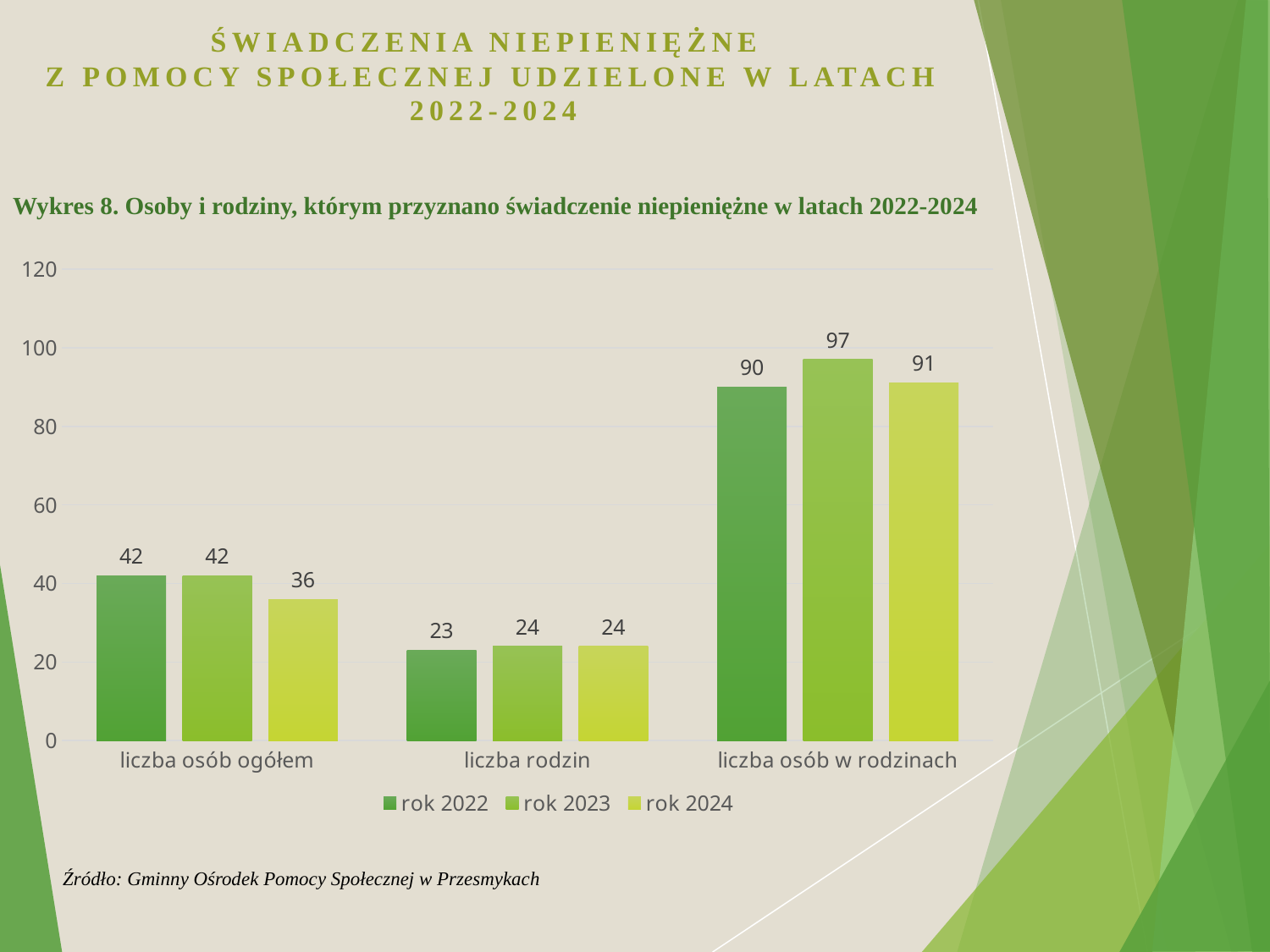
How many categories are shown on the x axis? 3 Which category has the lowest value in the 'rok 2024' series? liczba rodzin What is the value for 'liczba rodzin' in the 'rok 2022' series? 23 What is the difference between the 'rok 2022' and 'rok 2024' values for 'liczba osób ogółem'? 6 What is the difference between the 'rok 2023' and 'rok 2022' values for 'liczba osób w rodzinach'? 7 How many series does the legend list? 3 What are the series names listed in the legend? rok 2022, rok 2023, rok 2024 What is the value for 'liczba osób w rodzinach' in the 'rok 2023' series? 97 What is the value for 'liczba osób ogółem' in the 'rok 2024' series? 36 Which category has the highest value in the 'rok 2022' series? liczba osób w rodzinach Which is larger for 'liczba osób w rodzinach': the 'rok 2023' value or the 'rok 2024' value? rok 2023 What kind of chart is shown on the slide? bar chart